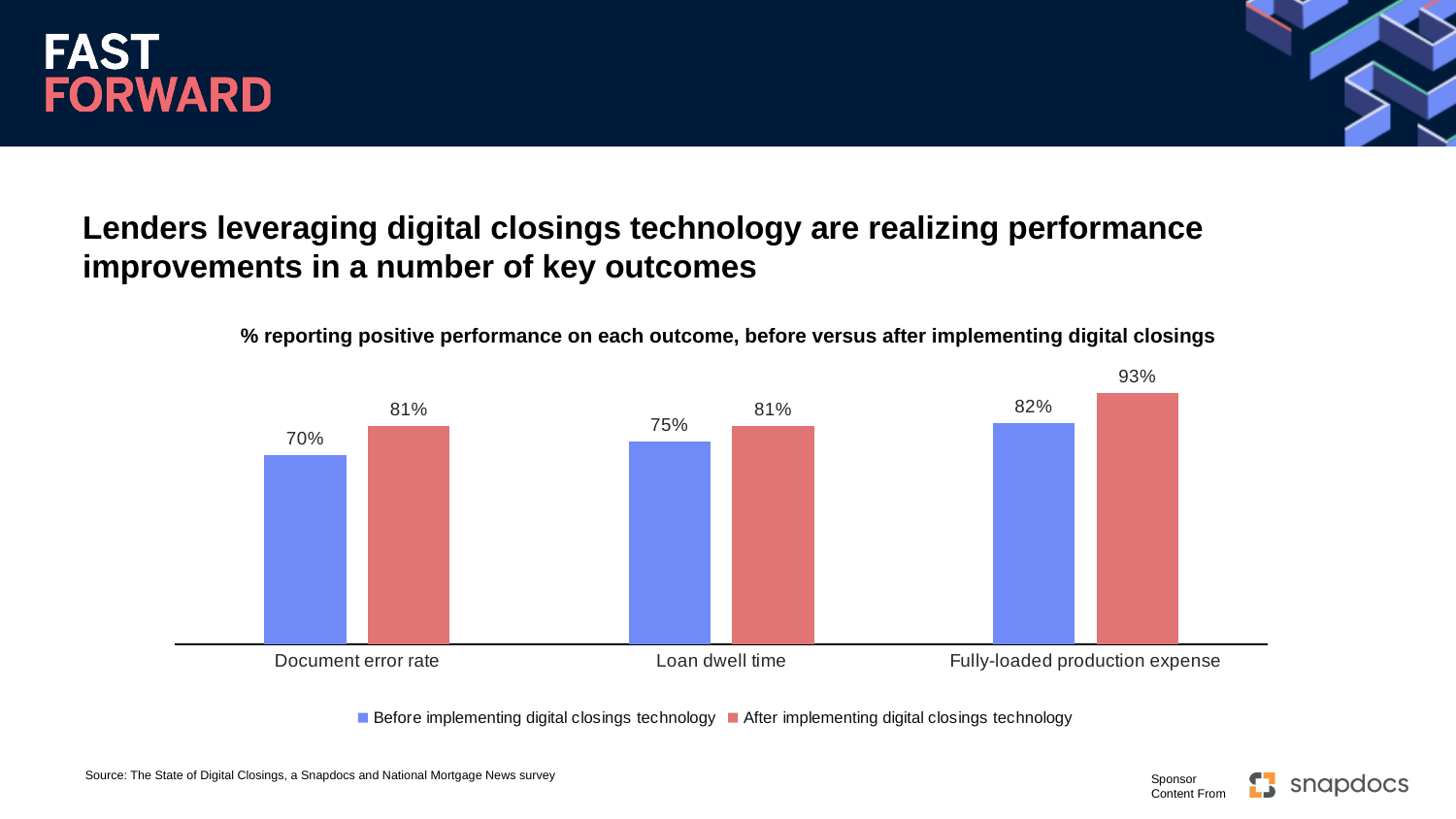
What percentage reported positive performance on Document error rate before implementing digital closings technology? 70% What colour represents the 'After implementing digital closings technology' series? Red What is the difference between the after and before values for Document error rate? 11% What percentage reported positive performance on Fully-loaded production expense after implementing digital closings technology? 93% How many series does the legend list? 2 Which is larger: the before value for Fully-loaded production expense or the after value for Loan dwell time? Before value for Fully-loaded production expense Which outcome has the highest value after implementing digital closings technology? Fully-loaded production expense What is the difference between the after and before values for Fully-loaded production expense? 11% What kind of chart is shown on the slide? Bar chart What is the value for Loan dwell time before implementing digital closings technology? 75% How many outcome categories are shown on the chart? 3 Which outcome has the lowest value before implementing digital closings technology? Document error rate